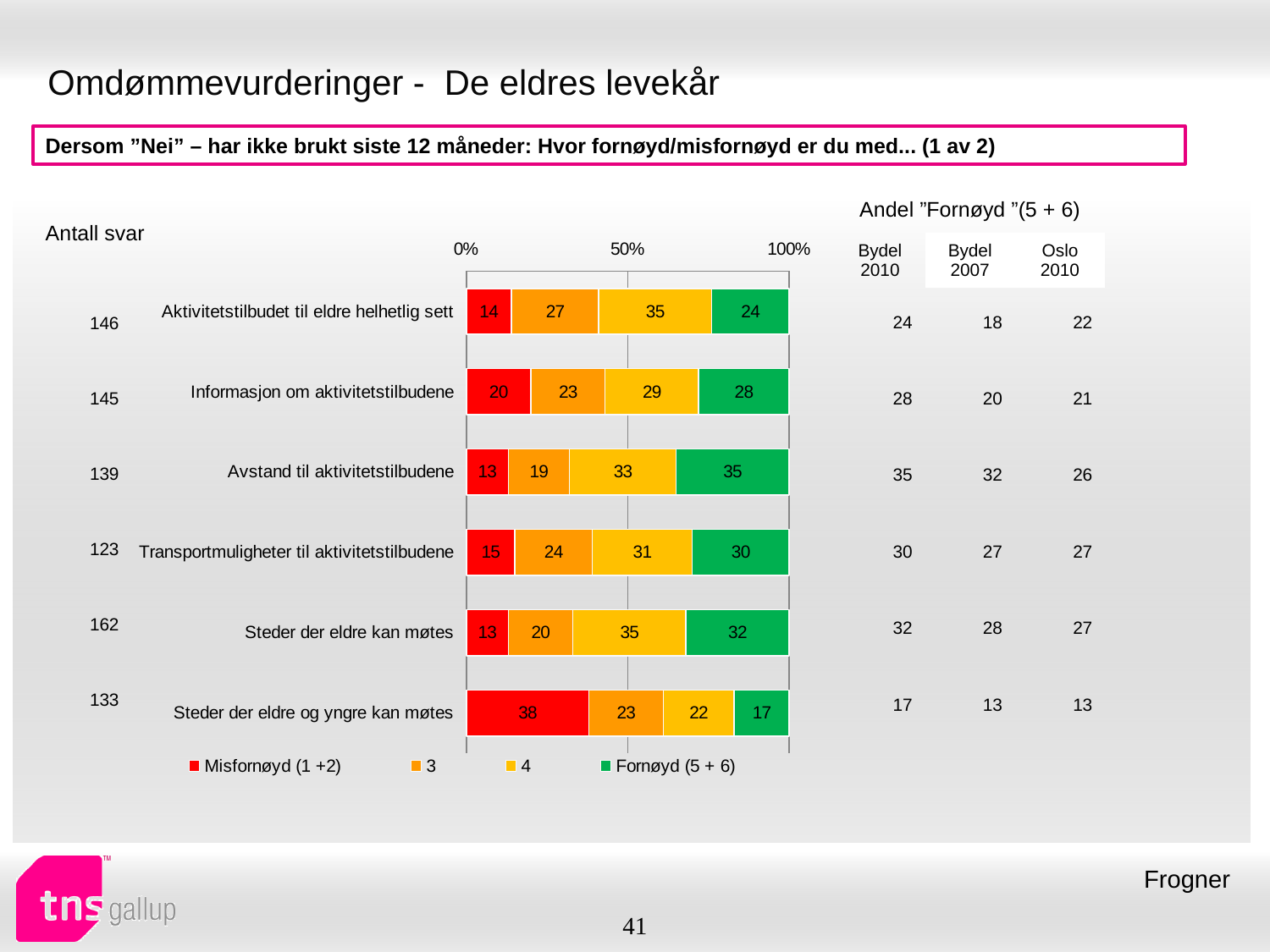
What is the difference between the Misfornøyd (1 +2) values for Steder der eldre og yngre kan møtes and Steder der eldre kan møtes? 25 How many series does the chart legend list? 4 Which colour represents the Fornøyd (5 + 6) series in the chart? green What kind of chart is shown on the slide? stacked bar chart What is the Misfornøyd (1 +2) value for Steder der eldre og yngre kan møtes? 38 Which category has the highest Fornøyd (5 + 6) value? Avstand til aktivitetstilbudene Which category has the lowest Fornøyd (5 + 6) value? Steder der eldre og yngre kan møtes What is the value of series 4 for Informasjon om aktivitetstilbudene? 29 What is the Fornøyd (5 + 6) value for Avstand til aktivitetstilbudene? 35 How many categories are plotted in the chart? 6 What is the total of the stacked bar for Aktivitetstilbudet til eldre helhetlig sett? 100 Which is larger: the Fornøyd (5 + 6) value for Transportmuligheter til aktivitetstilbudene or for Aktivitetstilbudet til eldre helhetlig sett? Transportmuligheter til aktivitetstilbudene